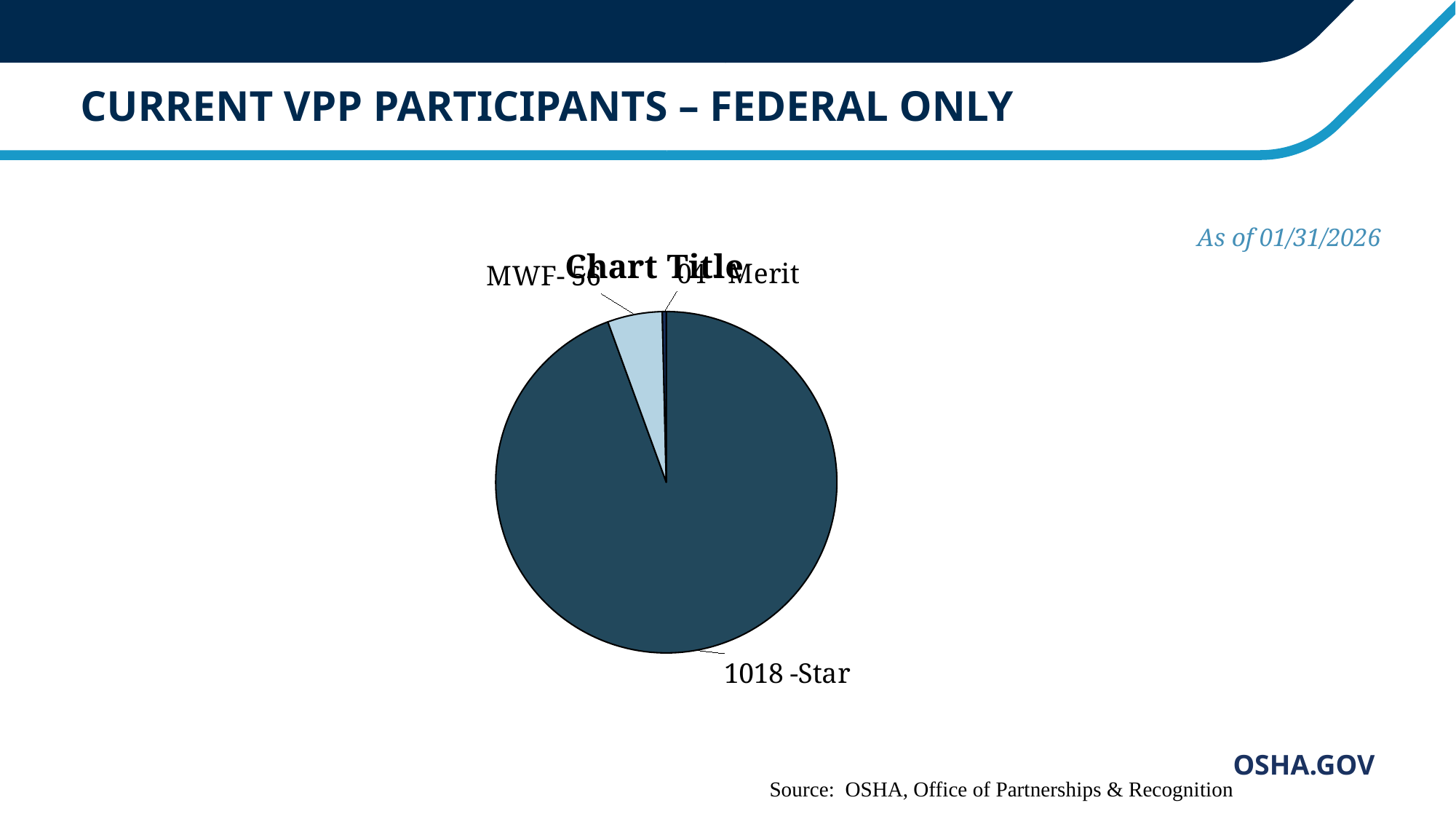
Which category has the largest slice of the pie? Star What kind of chart is shown on the slide? pie chart What is the slide's heading above the chart? CURRENT VPP PARTICIPANTS – FEDERAL ONLY Which slice is larger, Star or MWF? Star Is the value for Star greater or less than 1000? greater What title is printed above the pie chart? Chart Title How many slices does the pie chart have? 3 Which category has the smallest slice of the pie? Merit What is the value shown for the Star slice? 1018 Which slice is larger, MWF or Merit? MWF